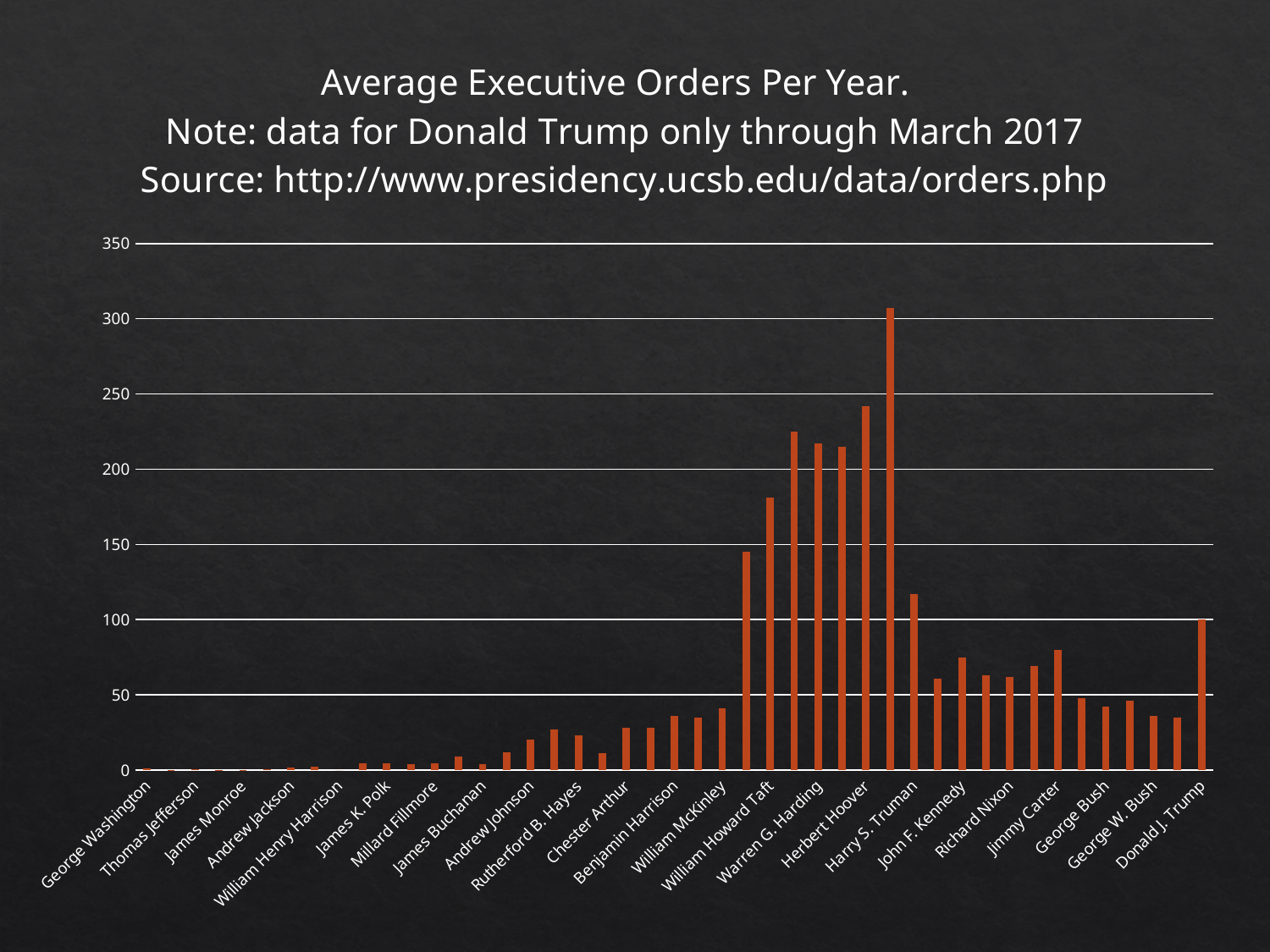
Is the value for William McKinley greater or less than 50? less What is the highest value shown on the vertical axis? 350 What kind of chart is shown on the slide? bar chart Do the values generally rise or fall from George Washington to Herbert Hoover? rise Which has a higher value, Jimmy Carter or Richard Nixon? Jimmy Carter Which has a higher value, Harry S. Truman or John F. Kennedy? Harry S. Truman Is the value for Jimmy Carter greater or less than 50? greater Is the value for William Howard Taft greater or less than 200? less Which has a higher value, Herbert Hoover or William Howard Taft? Herbert Hoover